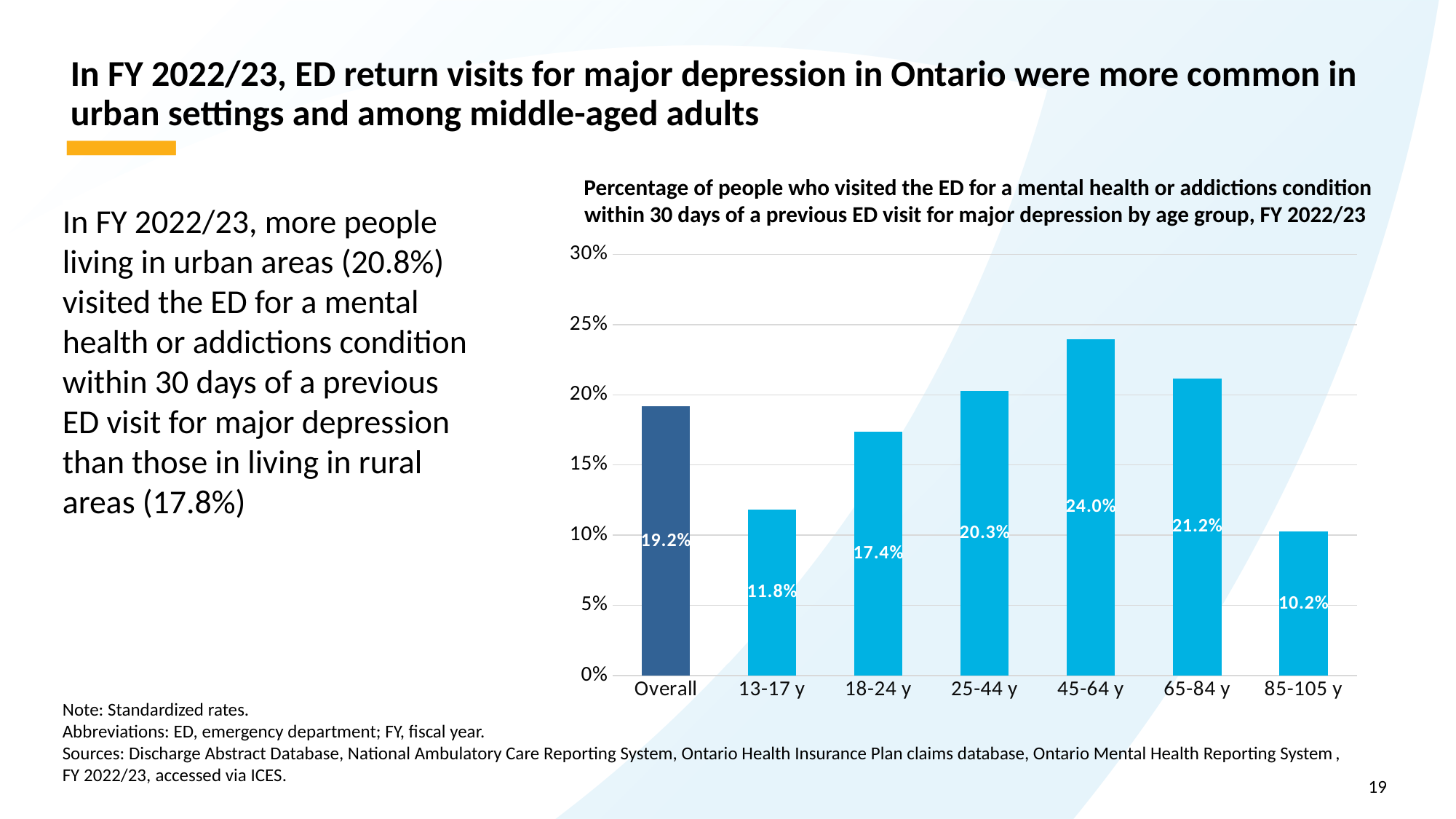
What is the value for the Overall bar? 19.2% What is the value for the 45-64 y age group? 24.0% What is the value for the 85-105 y age group? 10.2% What is the difference between the Overall value and the value for 85-105 y? 9.0% What is the difference between the values for 45-64 y and 13-17 y? 12.2% How many bars are shown in the chart? 7 Is the value for 18-24 y greater or less than 15%? greater Which is larger, the value for 25-44 y or the value for 65-84 y? 65-84 y Which age group has the highest value? 45-64 y Which category has the lowest value? 85-105 y Which bar is shown in a different (darker) colour from the others? Overall What kind of chart is shown on the slide? Bar chart